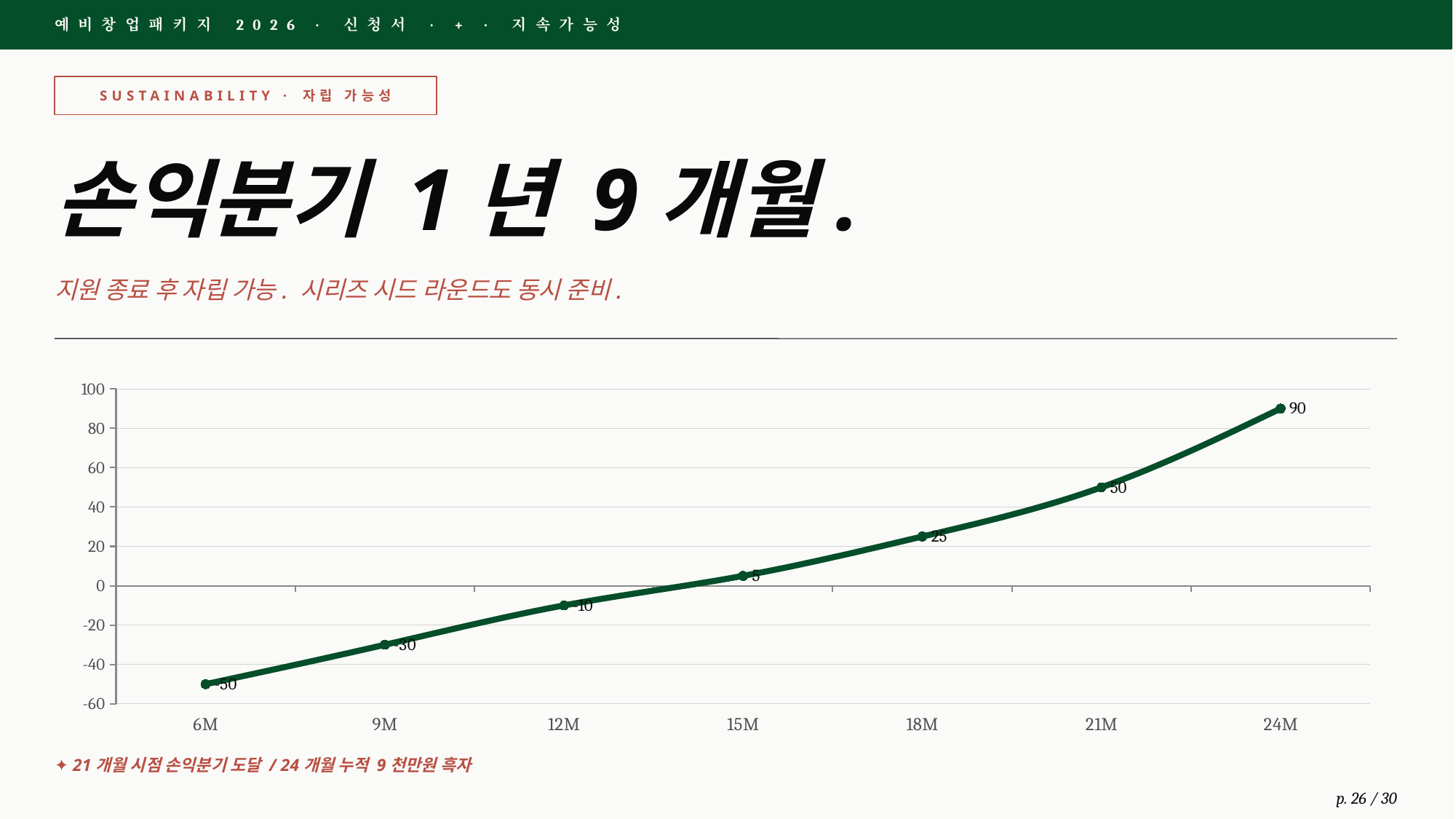
Which is larger, the value at 18M or the value at 12M? 18M What is the value at 18M? 25 What is the value at 6M? -50 What type of chart is shown on the slide? line chart Which point on the x axis has the lowest value? 6M What is the difference between the values at 24M and 21M? 40 Which point on the x axis has the highest value? 24M What is the value at 15M? 5 What is the value at 21M? 50 Do the values rise or fall from 6M to 24M? rise How many data points are plotted on the line? 7 What is the value at 24M? 90